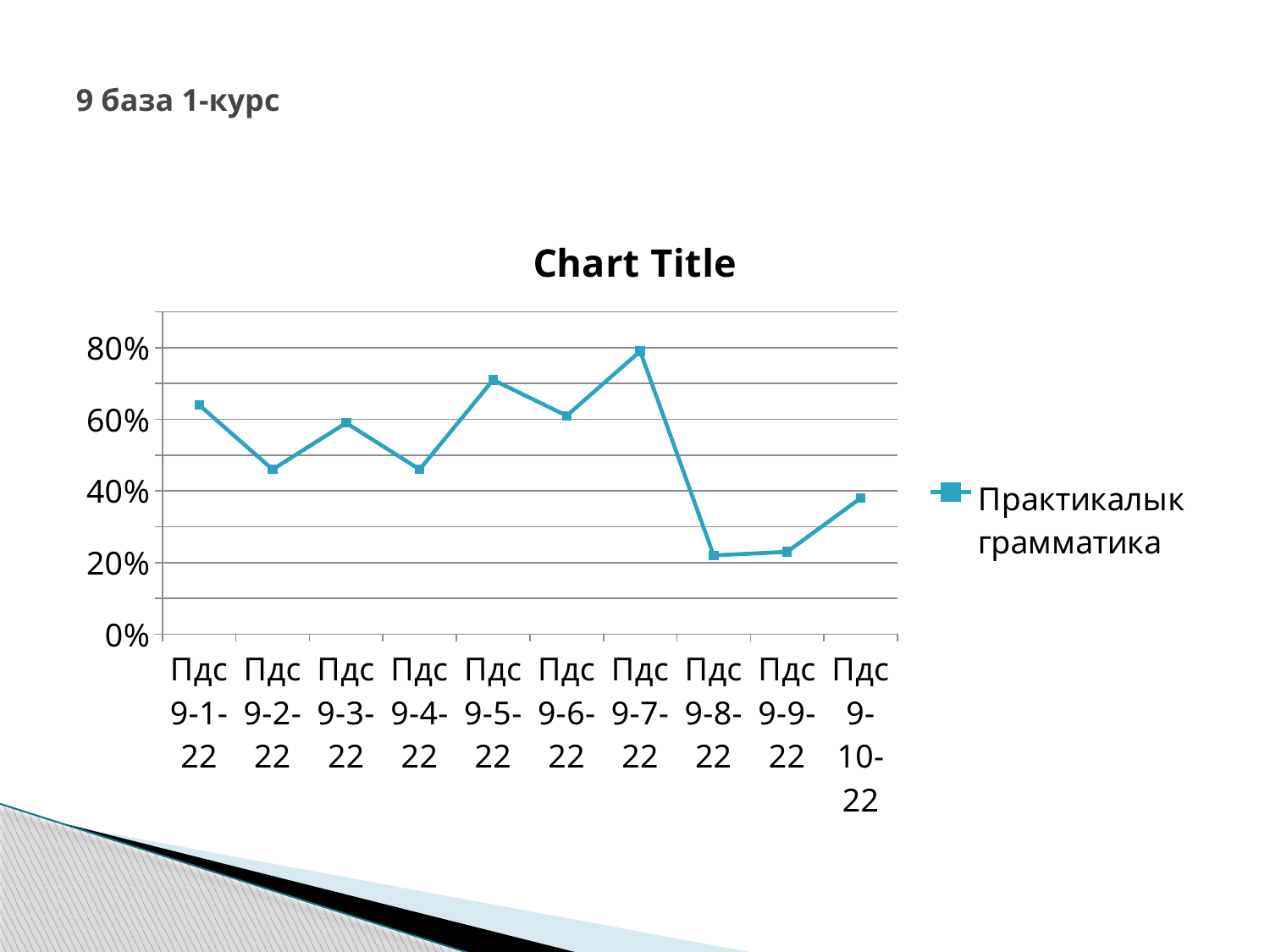
Is the value for Пдс 9-8-22 greater or less than 40%? less Is the value for Пдс 9-1-22 greater or less than 60%? greater How many categories are plotted along the x axis? 10 What series name is shown in the legend? Практикалык грамматика Is the value for Пдс 9-7-22 greater or less than 60%? greater Which category has the highest value for Практикалык грамматика? Пдс 9-7-22 How many series does the legend list? 1 What kind of chart is shown on the slide? line chart What is the title of the chart? Chart Title Which is larger, the value for Пдс 9-5-22 or the value for Пдс 9-2-22? Пдс 9-5-22 Does the value rise or fall from Пдс 9-7-22 to Пдс 9-8-22? fall